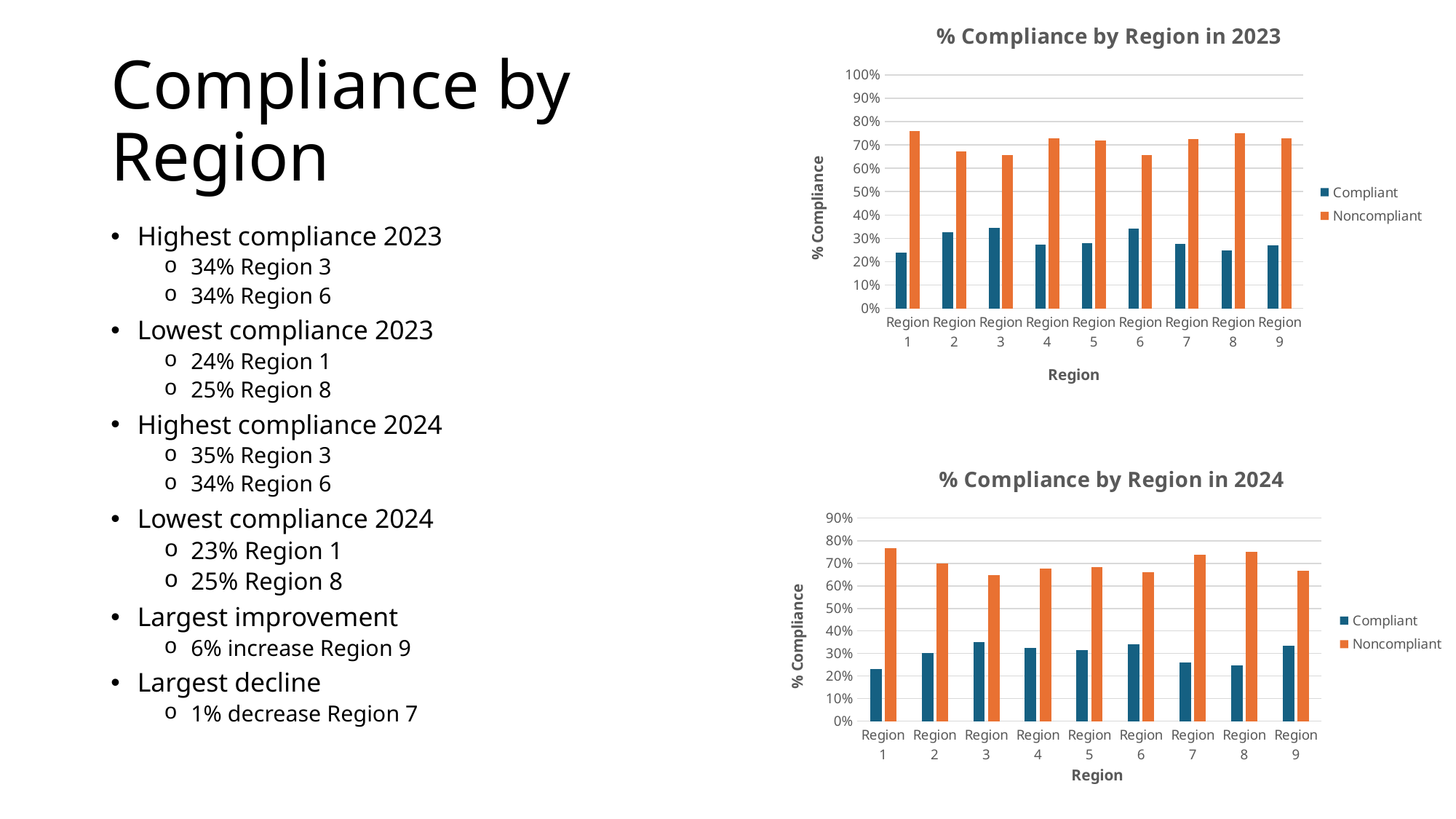
In the '% Compliance by Region in 2023' chart, is the Compliant value for Region 1 greater or less than 30%? less In the '% Compliance by Region in 2024' chart, is the Compliant value for Region 3 greater or less than 30%? greater What kind of chart is '% Compliance by Region in 2023'? bar chart How many regions are shown on the x axis of the '% Compliance by Region in 2024' chart? 9 How many series does the legend of the '% Compliance by Region in 2023' chart list? 2 In the '% Compliance by Region in 2024' chart, which series has the larger value for Region 1, Compliant or Noncompliant? Noncompliant In the '% Compliance by Region in 2024' chart, is the Noncompliant value for Region 7 greater or less than 70%? greater In the '% Compliance by Region in 2023' chart, which is larger, the Compliant value for Region 3 or the Compliant value for Region 1? Region 3 What is the y-axis title of the '% Compliance by Region in 2024' chart? % Compliance What are the two legend entries in the '% Compliance by Region in 2023' chart? Compliant, Noncompliant